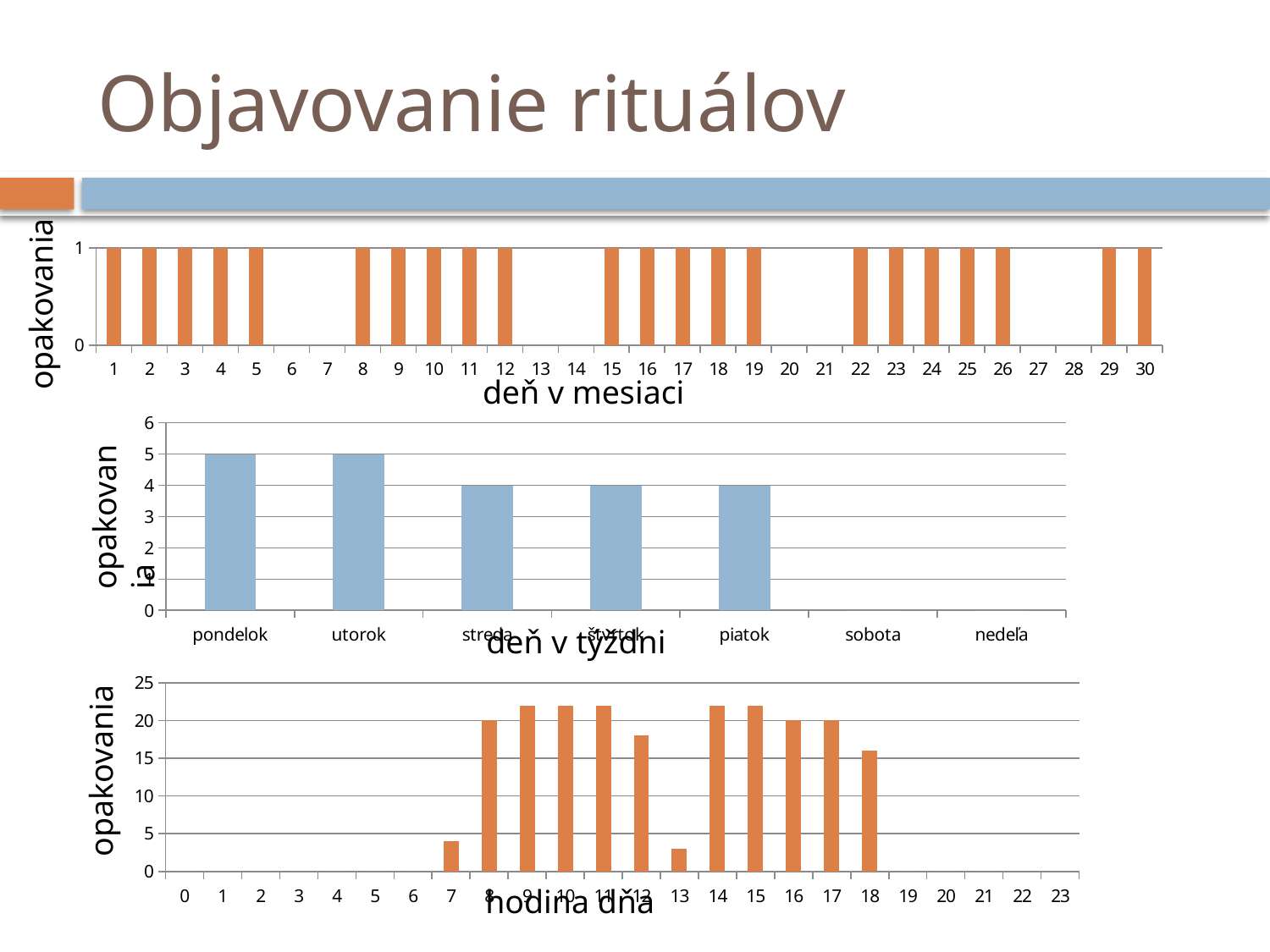
In the chart with x axis 'deň v týždni', which is larger, the value for pondelok or the value for štvrtok? pondelok What kind of chart is the chart with x axis 'hodina dňa'? bar chart In the chart with x axis 'deň v týždni', what is the value for streda? 4 In the chart with x axis 'deň v mesiaci', how many categories are shown on the x axis? 30 In the chart with x axis 'hodina dňa', what is the value for hour 8? 20 In the chart with x axis 'deň v mesiaci', what is the value for day 3? 1 In the chart with x axis 'deň v týždni', what is the value for pondelok? 5 In the chart with x axis 'hodina dňa', is the value for hour 9 greater or less than 20? greater In the chart with x axis 'deň v týždni', what is the difference between the values for utorok and piatok? 1 In the chart with x axis 'deň v mesiaci', what is the value for day 6? 0 In the chart with x axis 'hodina dňa', is the value for hour 13 greater or less than 5? less In the chart with x axis 'deň v týždni', how many categories are on the x axis? 7